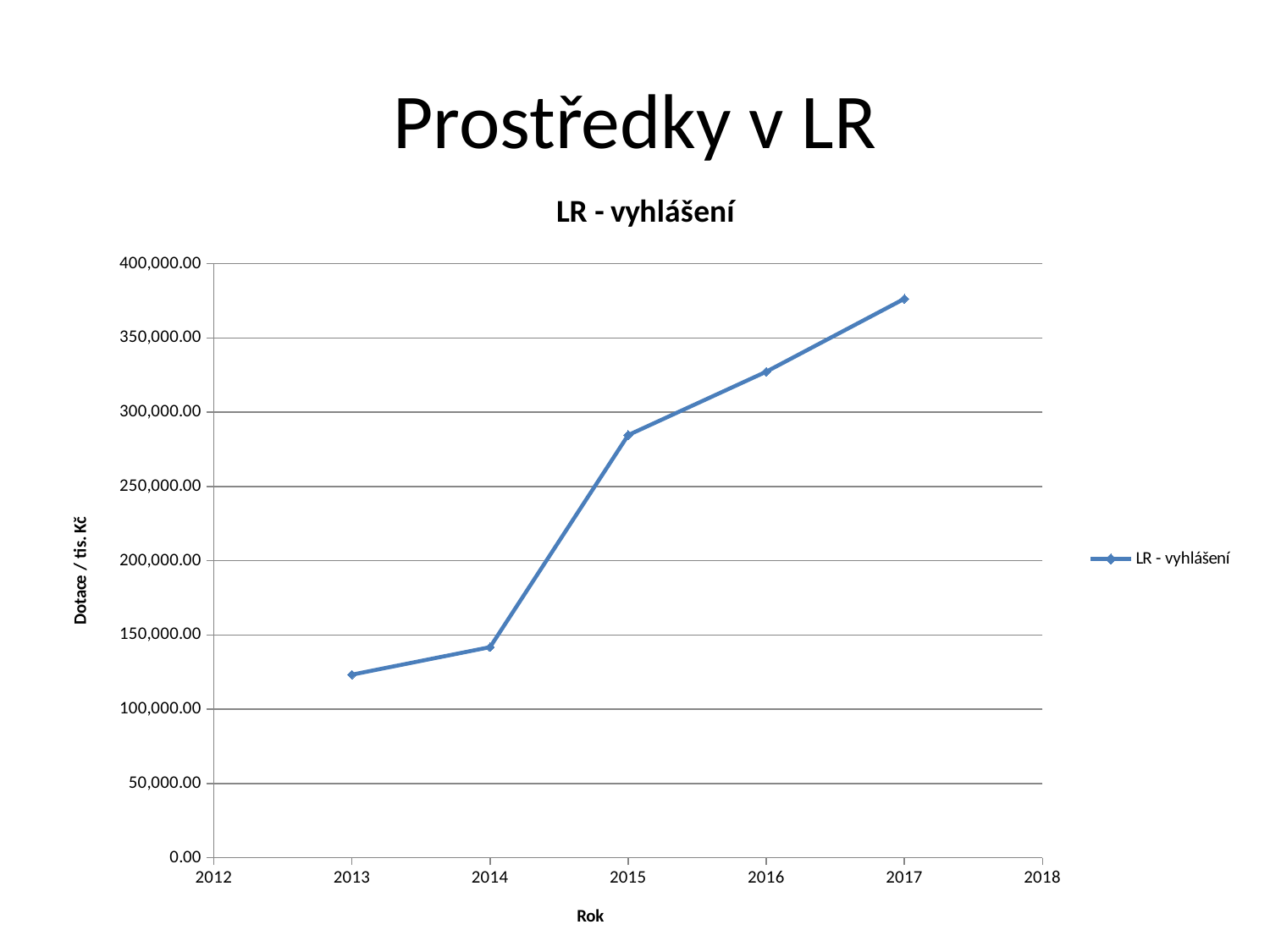
What kind of chart is shown on the slide? line chart What is the title of the chart? LR - vyhlášení How many series does the legend list? 1 Which year has the highest value? 2017 Is the value for 2016 greater or less than 300,000.00? greater How many data points are plotted on the line? 5 Which is larger, the value for 2014 or the value for 2015? 2015 Is the value for 2015 greater or less than 300,000.00? less Do the values rise or fall from 2013 to 2017? rise Is the value for 2013 greater or less than 150,000.00? less Which year has the lowest value? 2013